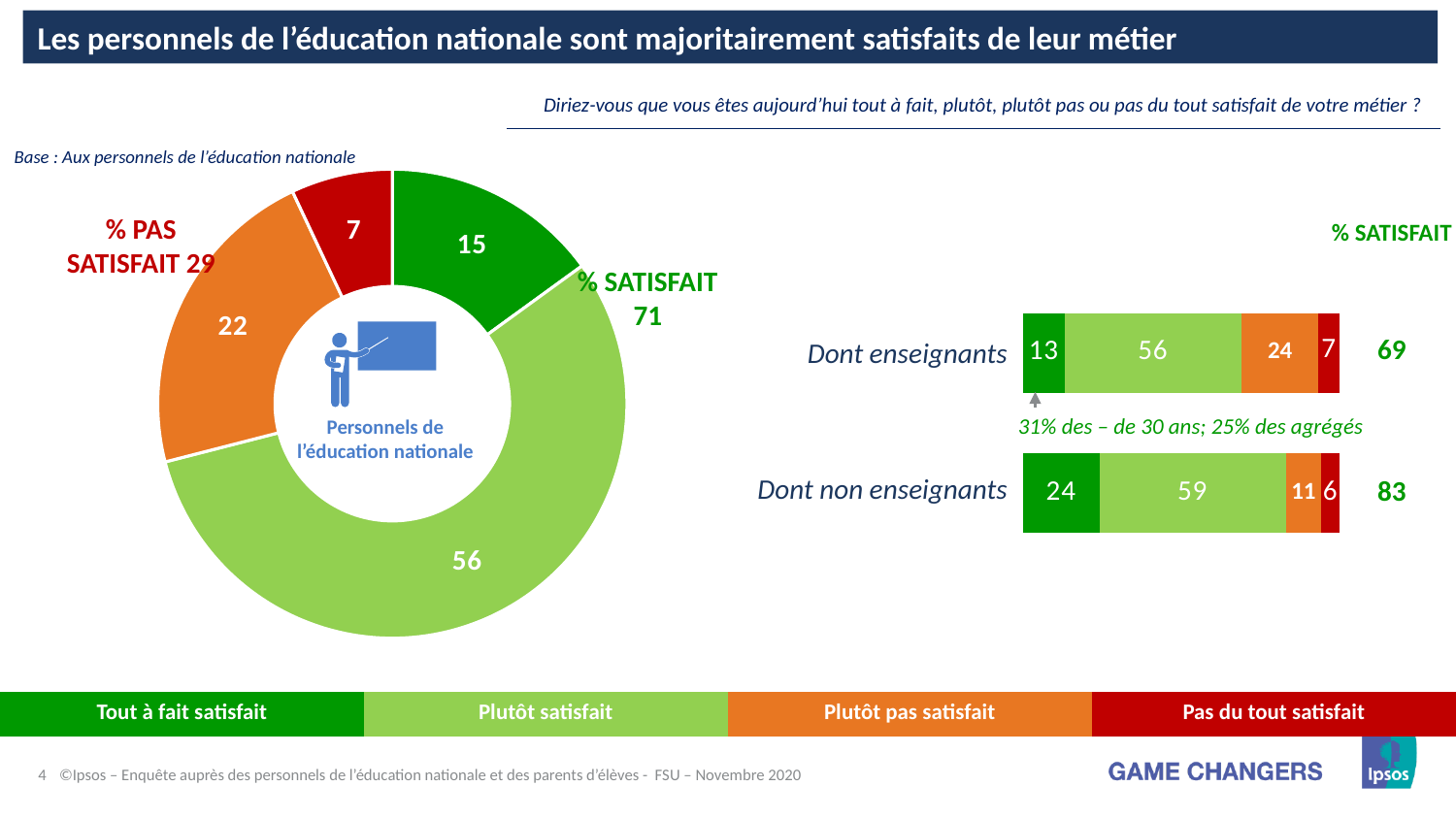
What kind of chart is shown on the left of the slide? Donut chart In the stacked bar chart, what is the difference in "% SATISFAIT" between "Dont non enseignants" and "Dont enseignants"? 14 In the stacked bar chart, what is the "Plutôt satisfait" value for "Dont non enseignants"? 59 In the stacked bar chart, what is the "Tout à fait satisfait" value for "Dont enseignants"? 13 In the stacked bar chart, which group has the higher "Plutôt pas satisfait" value, "Dont enseignants" or "Dont non enseignants"? Dont enseignants How many categories does the legend at the bottom of the slide list? 4 In the stacked bar chart, what is the "% SATISFAIT" total shown for "Dont non enseignants"? 83 In the donut chart, which category has the largest share? Plutôt satisfait In the donut chart, what is the value for "Pas du tout satisfait"? 7 In the donut chart, which category has the smallest share? Pas du tout satisfait In the donut chart, what is the difference between "Plutôt pas satisfait" and "Tout à fait satisfait"? 7 In the donut chart, what is the value for "Plutôt satisfait"? 56